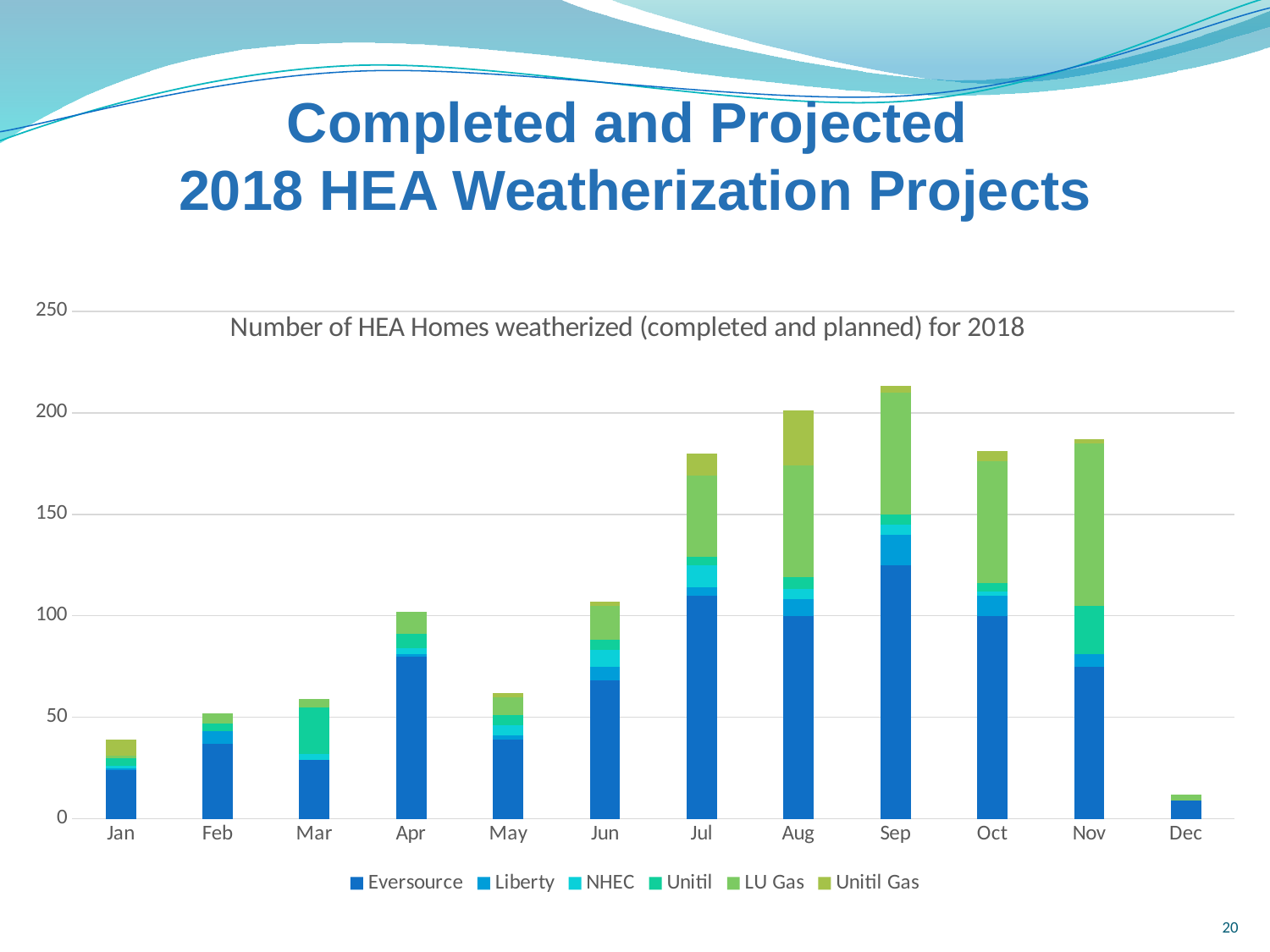
Which month has a larger total, Sep or Jul? Sep What kind of chart is shown on the slide? Stacked bar chart Is the total value for Jul greater or less than 200? less Is the total value for Oct greater or less than 150? greater Which month has the lowest total number of homes weatherized? Dec What is the title of the chart? Number of HEA Homes weatherized (completed and planned) for 2018 How many months are shown on the x axis of the chart? 12 Do the total values rise or fall from Jan to Apr? rise Is the total value for Sep greater or less than 200? greater How many series does the chart's legend list? 6 Which month has the highest total number of homes weatherized? Sep